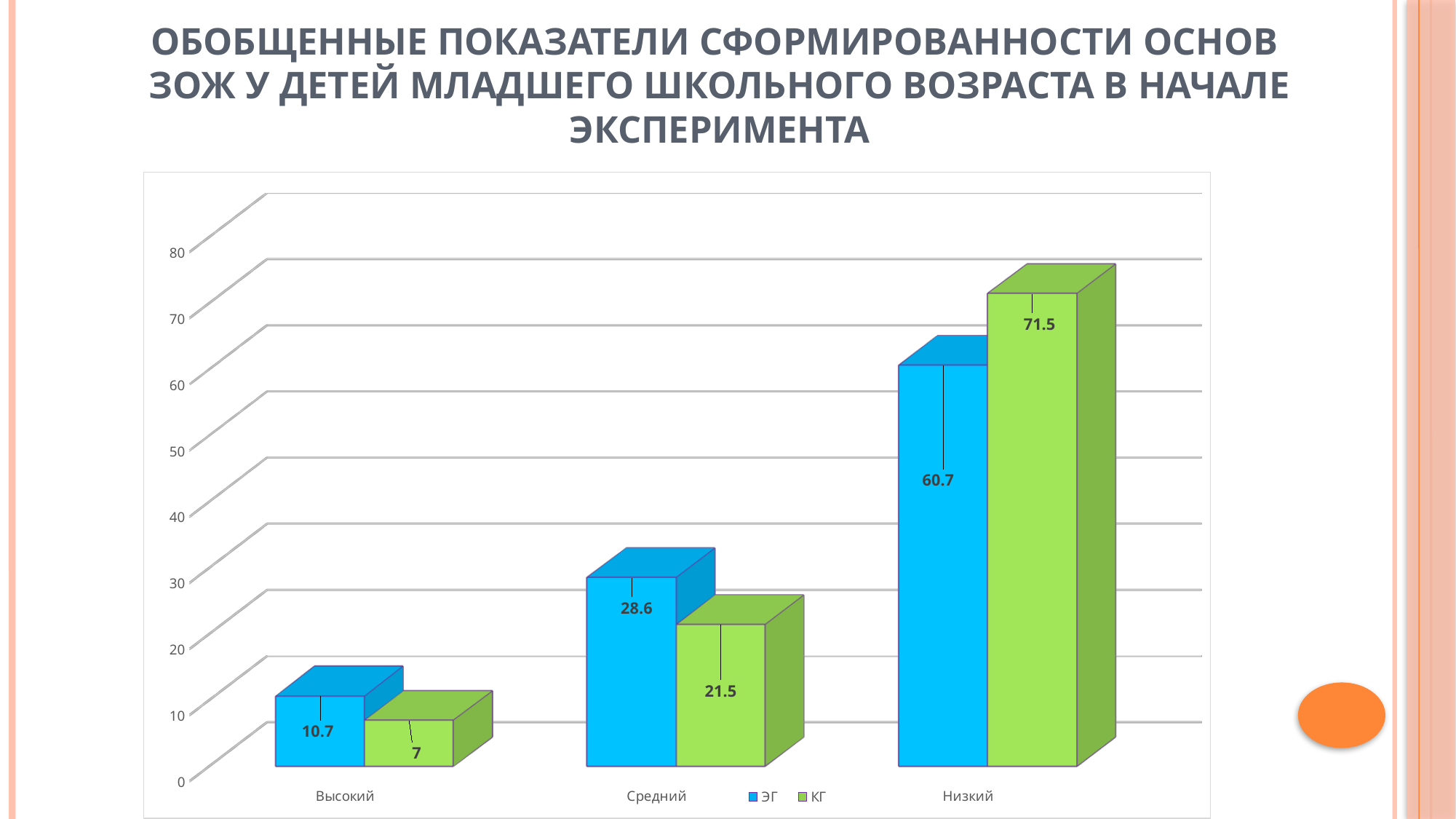
Which colour represents the КГ series? Green Which is larger in the Средний category, ЭГ or КГ? ЭГ What is the difference between the КГ and ЭГ values in the Низкий category? 10.8 What is the value for ЭГ in the Средний category? 28.6 What is the value for КГ in the Низкий category? 71.5 What is the value for КГ in the Средний category? 21.5 What kind of chart is shown on the slide? Bar chart Which category has the lowest value for the КГ series? Высокий What is the value for ЭГ in the Высокий category? 10.7 How many series does the legend list? 2 How many categories are shown on the x axis? 3 Which category has the highest value for the ЭГ series? Низкий